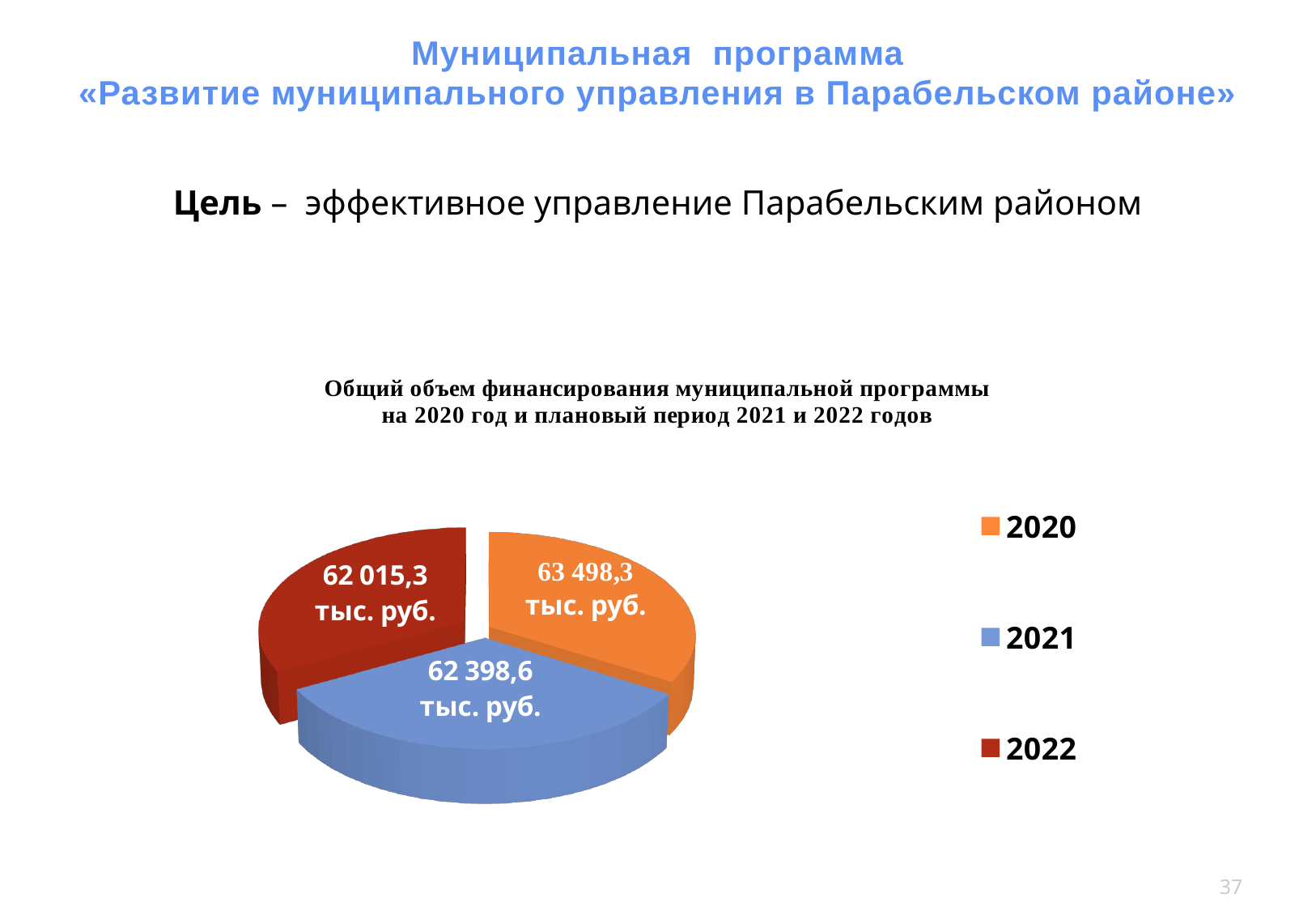
What is the funding value for 2020 in the pie chart? 63 498,3 тыс. руб. What is the funding value for 2021 in the pie chart? 62 398,6 тыс. руб. How many slices does the pie chart have? 3 Which colour represents 2021 in the pie chart? Blue What type of chart is shown on the slide? Pie chart Which year has the largest funding value in the pie chart? 2020 How many entries does the legend list? 3 What is the funding value for 2022 in the pie chart? 62 015,3 тыс. руб. Which year has the smallest funding value in the pie chart? 2022 Which is larger, the funding value for 2020 or for 2022? 2020 What is the difference between the funding values for 2021 and 2022? 383,3 тыс. руб. What is the difference between the funding values for 2020 and 2021? 1 099,7 тыс. руб.